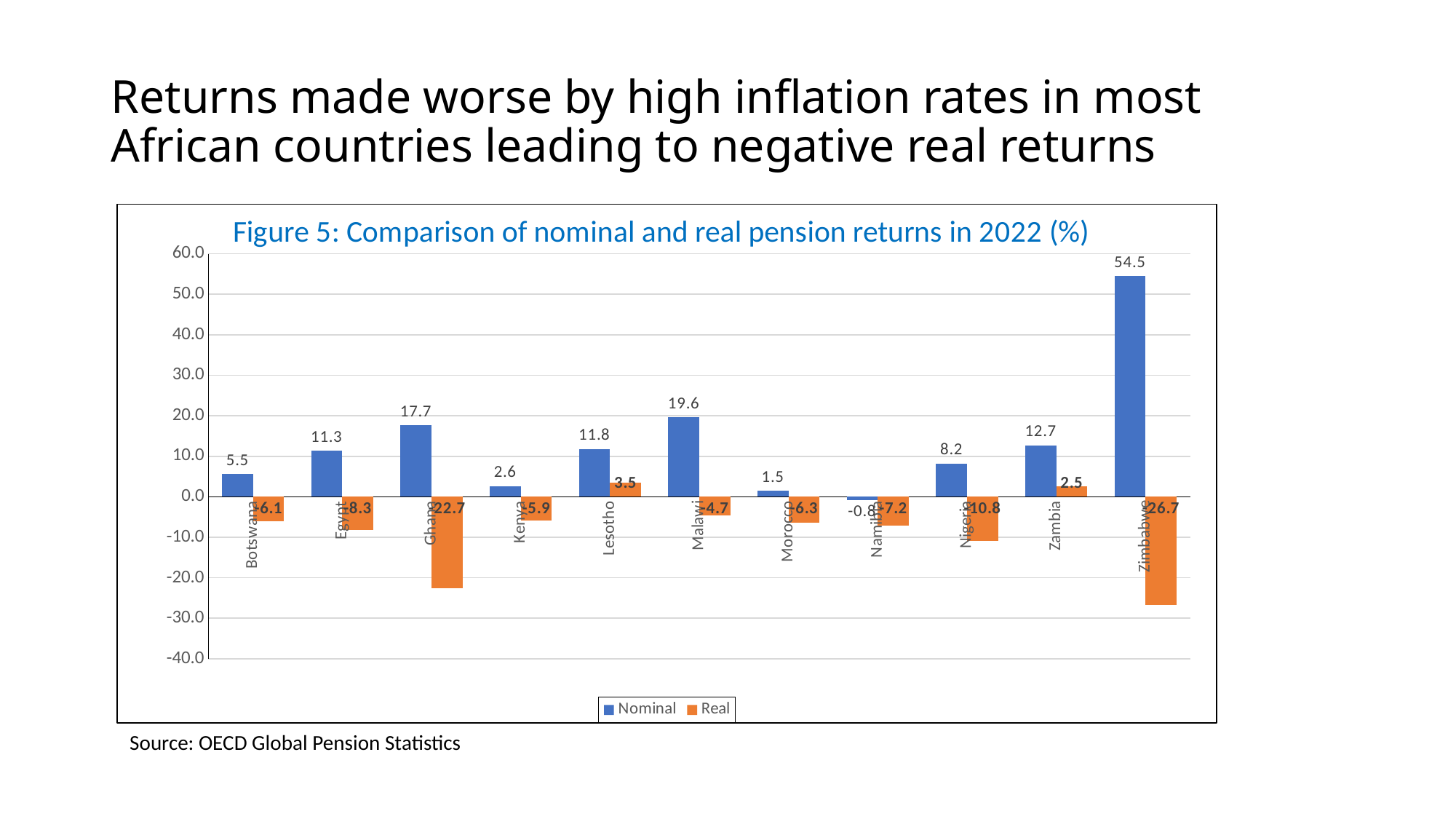
How many countries have a positive real pension return? 2 What kind of chart is shown? Bar chart What is the nominal pension return for Zimbabwe? 54.5 What is the real pension return for Nigeria? -10.8 Which country has the lowest nominal pension return? Namibia How many countries are shown on the x axis? 11 What is the real pension return for Lesotho? 3.5 Which country has the highest nominal pension return? Zimbabwe Which country has the lowest real pension return? Zimbabwe How many series does the legend list? 2 What is the difference between the nominal returns of Malawi and Ghana? 1.9 Which has the larger nominal return, Egypt or Lesotho? Lesotho